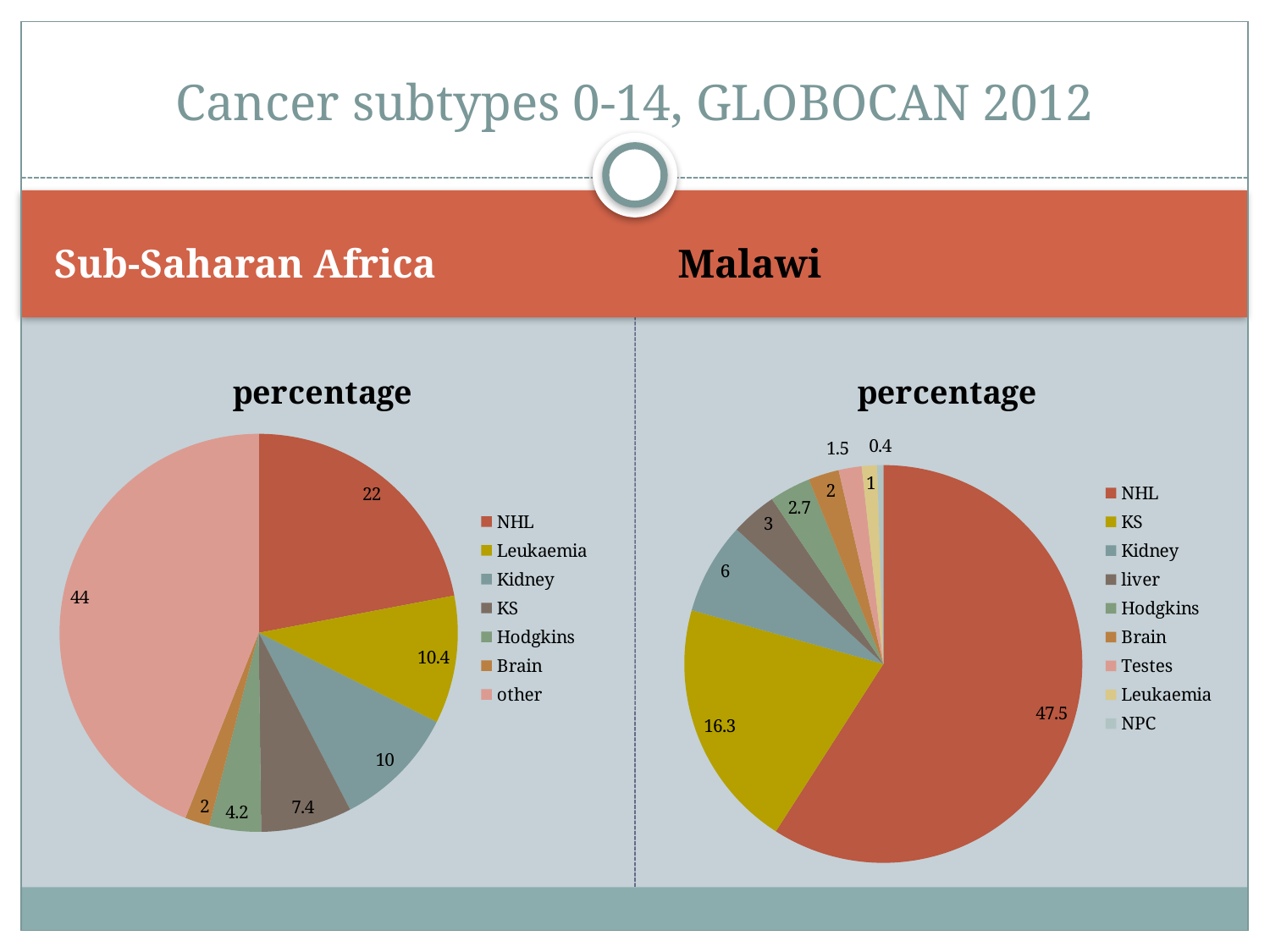
In the Sub-Saharan Africa pie chart on the left, what is the value for Leukaemia? 10.4 In the Malawi pie chart on the right, which category has the largest slice? NHL In the Malawi pie chart on the right, what is the value for NPC? 0.4 In the Malawi pie chart on the right, how many categories does the legend list? 9 In the Malawi pie chart on the right, which is larger, the value for Kidney or the value for liver? Kidney What kind of chart is used for the Malawi data on the right? pie chart In the Sub-Saharan Africa pie chart on the left, what is the value for NHL? 22 In the Sub-Saharan Africa pie chart on the left, what is the difference between the values for Kidney and KS? 2.6 In the Sub-Saharan Africa pie chart on the left, which category has the smallest slice? Brain In the Sub-Saharan Africa pie chart on the left, which category has the largest slice? other In the Sub-Saharan Africa pie chart on the left, how many categories does the legend list? 7 In the Malawi pie chart on the right, what is the value for KS? 16.3